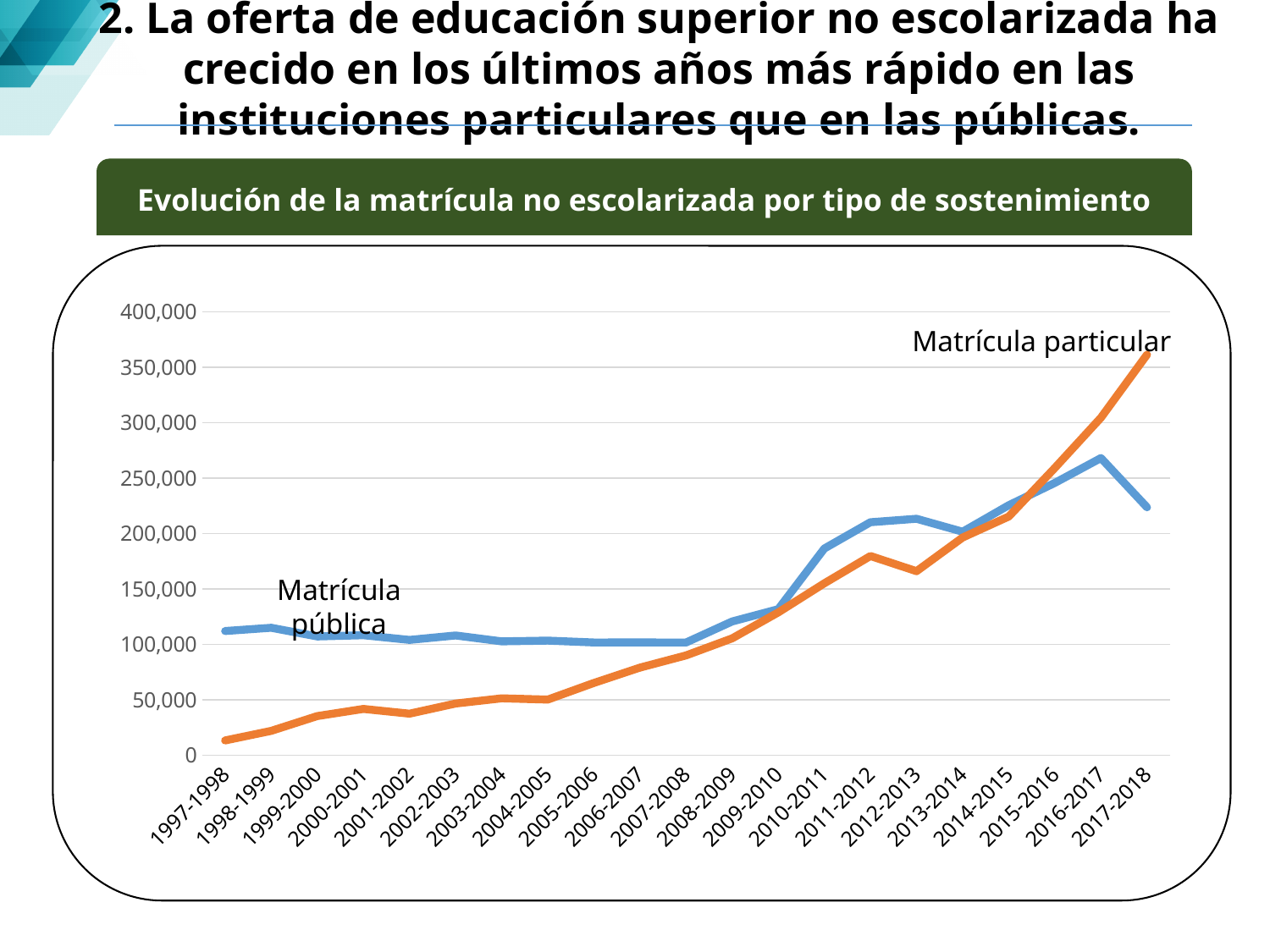
In 2005-2006, which series has the larger value, Matrícula pública or Matrícula particular? Matrícula pública In which academic year does Matrícula particular reach its highest value? 2017-2018 What colour is the line for Matrícula particular? Orange In 2017-2018, which series has the larger value, Matrícula pública or Matrícula particular? Matrícula particular How many data series are plotted in the chart? 2 What is the title of the chart? Evolución de la matrícula no escolarizada por tipo de sostenimiento How many academic years are plotted along the x axis? 21 In which academic year does Matrícula pública reach its highest value? 2016-2017 What kind of chart is shown on the slide? Line chart Is the value for Matrícula particular in 1997-1998 greater or less than 50,000? less In which academic year is Matrícula particular at its lowest? 1997-1998 Is the value for Matrícula particular in 2017-2018 greater or less than 300,000? greater